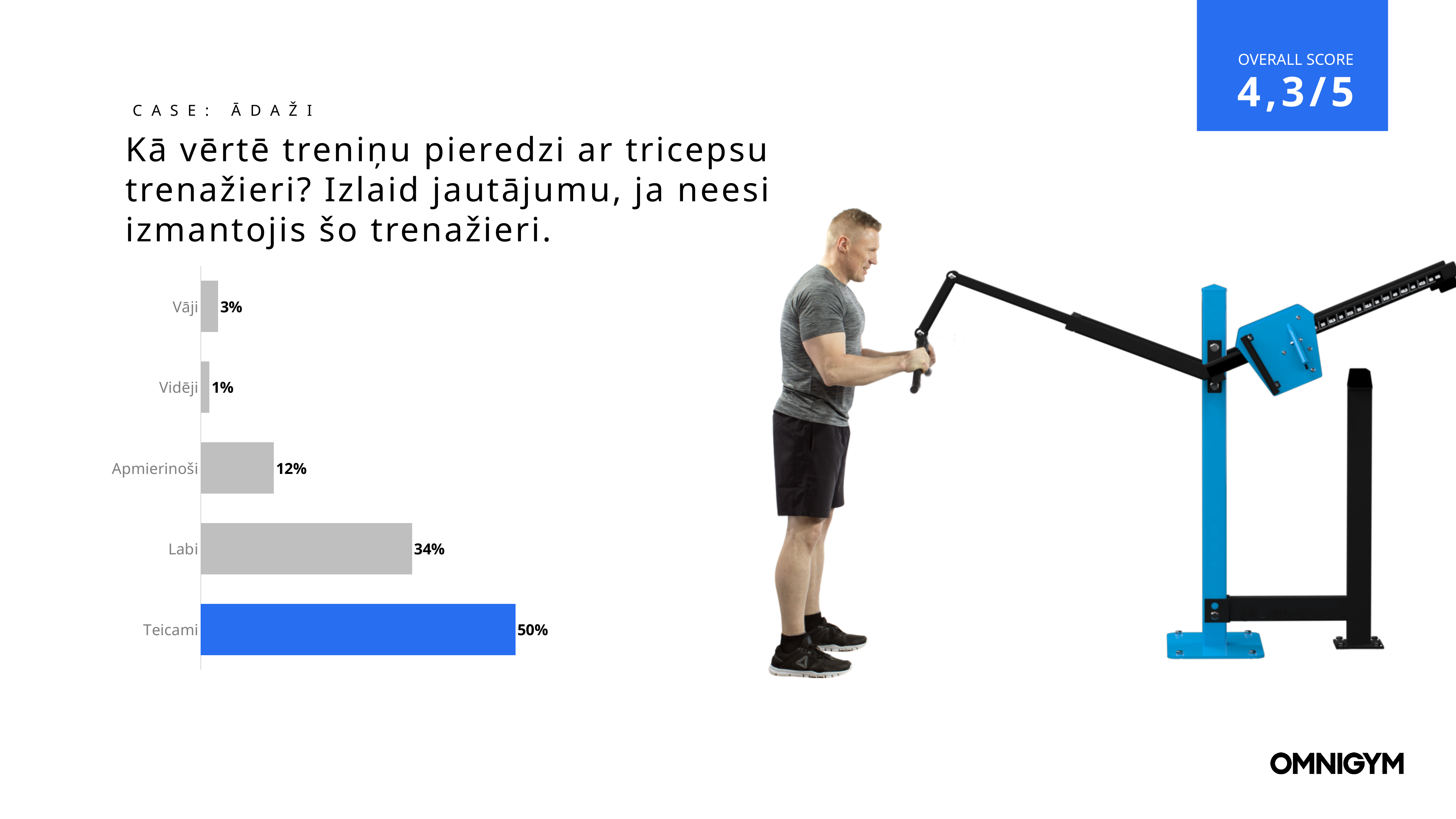
What percentage of respondents rated the triceps trainer experience as "Teicami"? 50% What is the value shown for "Apmierinoši"? 12% Which category has the highest value? Teicami What is the difference between the values for "Teicami" and "Labi"? 16% Which category has the lowest value? Vidēji Which is larger, the value for "Apmierinoši" or the value for "Vāji"? Apmierinoši Which bar in the chart is coloured blue rather than grey? Teicami How many categories are shown in the bar chart? 5 What overall score is shown in the box at the top right of the slide? 4,3/5 What is the value shown for "Vāji"? 3% What kind of chart is shown on the slide? Bar chart What is the value shown for "Labi"? 34%